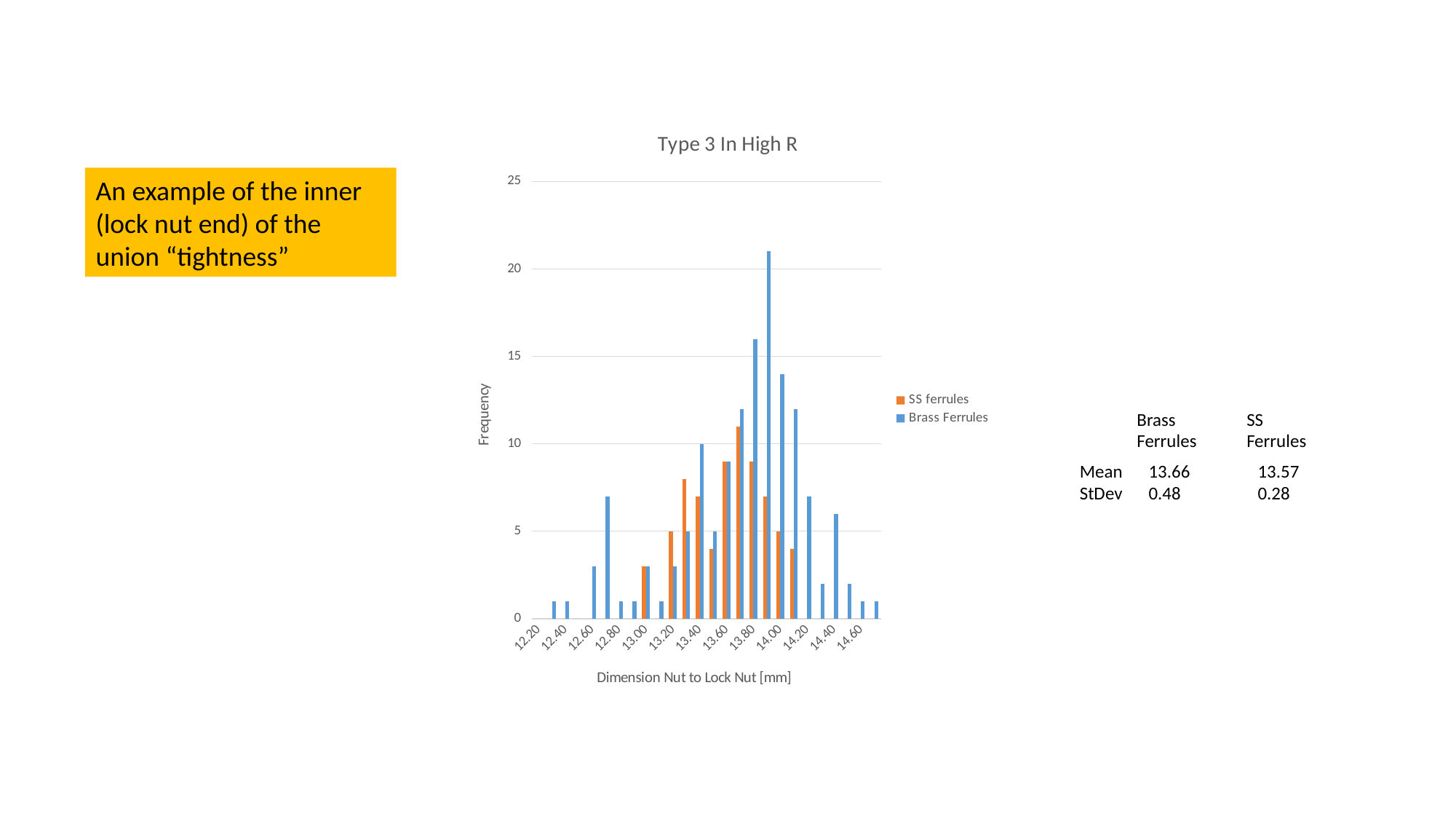
Is the tallest SS ferrules bar greater or less than 10? greater What is the highest value shown on the y axis? 25 Which series spans a wider range of x-axis values, SS ferrules or Brass Ferrules? Brass Ferrules How many series does the legend list? 2 Is the tallest Brass Ferrules bar greater or less than 20? greater What is the x-axis title of the chart? Dimension Nut to Lock Nut [mm] What kind of chart is shown on the slide? bar chart Which series has the tallest bar in the chart, SS ferrules or Brass Ferrules? Brass Ferrules What is the title of the chart? Type 3 In High R How many tick labels are shown on the x axis? 13 Is the tallest SS ferrules bar greater or less than 15? less